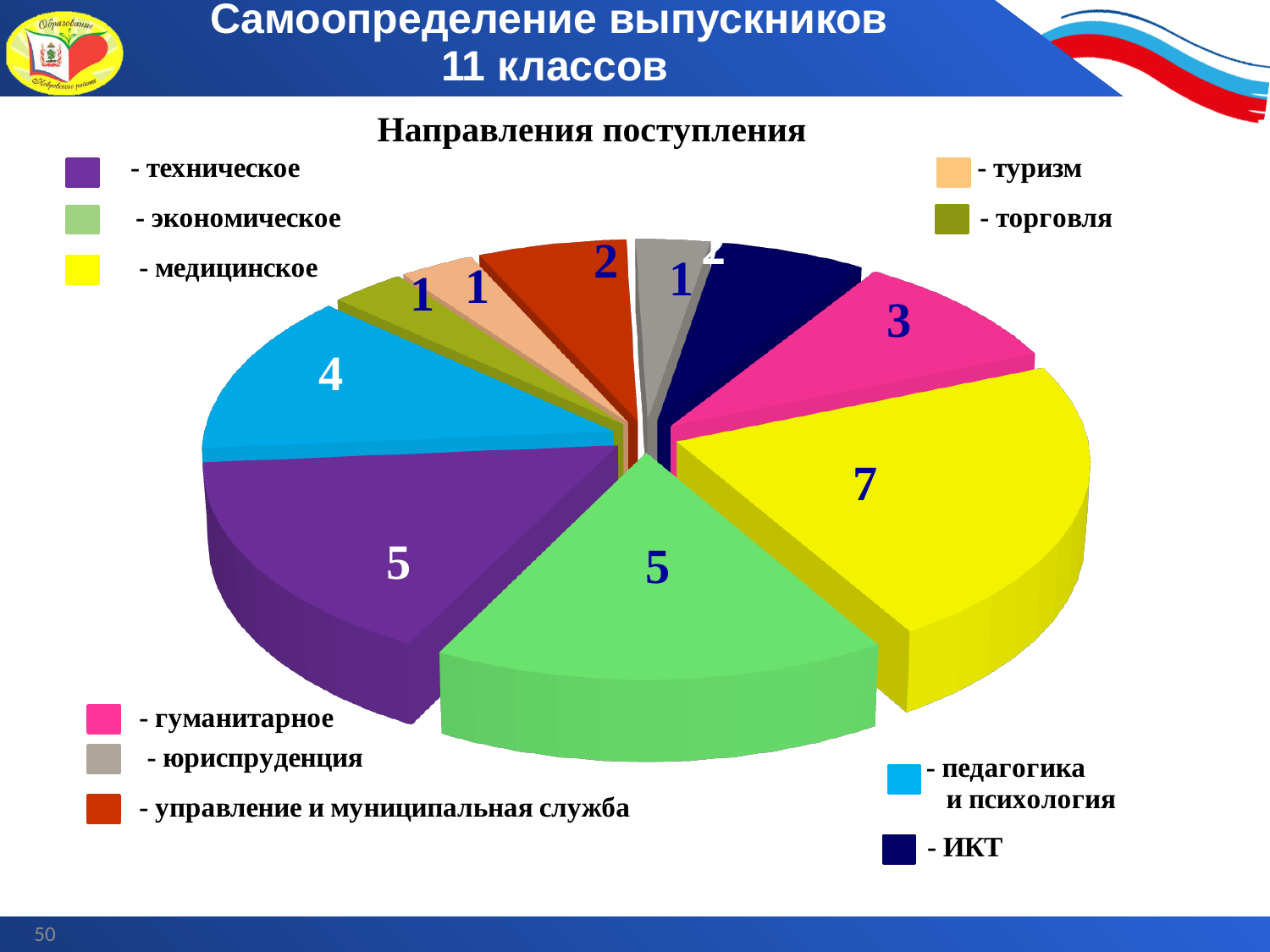
What is the value for гуманитарное? 3 Which is larger, the value for техническое or the value for педагогика и психология? техническое Which category has the largest slice? медицинское What is the value for туризм? 1 What is the value for управление и муниципальная служба? 2 What is the title of the chart? Направления поступления What is the value for медицинское? 7 How many categories does the legend list? 10 What kind of chart is shown on the slide? pie chart What is the difference between the values for медицинское and гуманитарное? 4 What is the value for педагогика и психология? 4 What is the value for торговля? 1